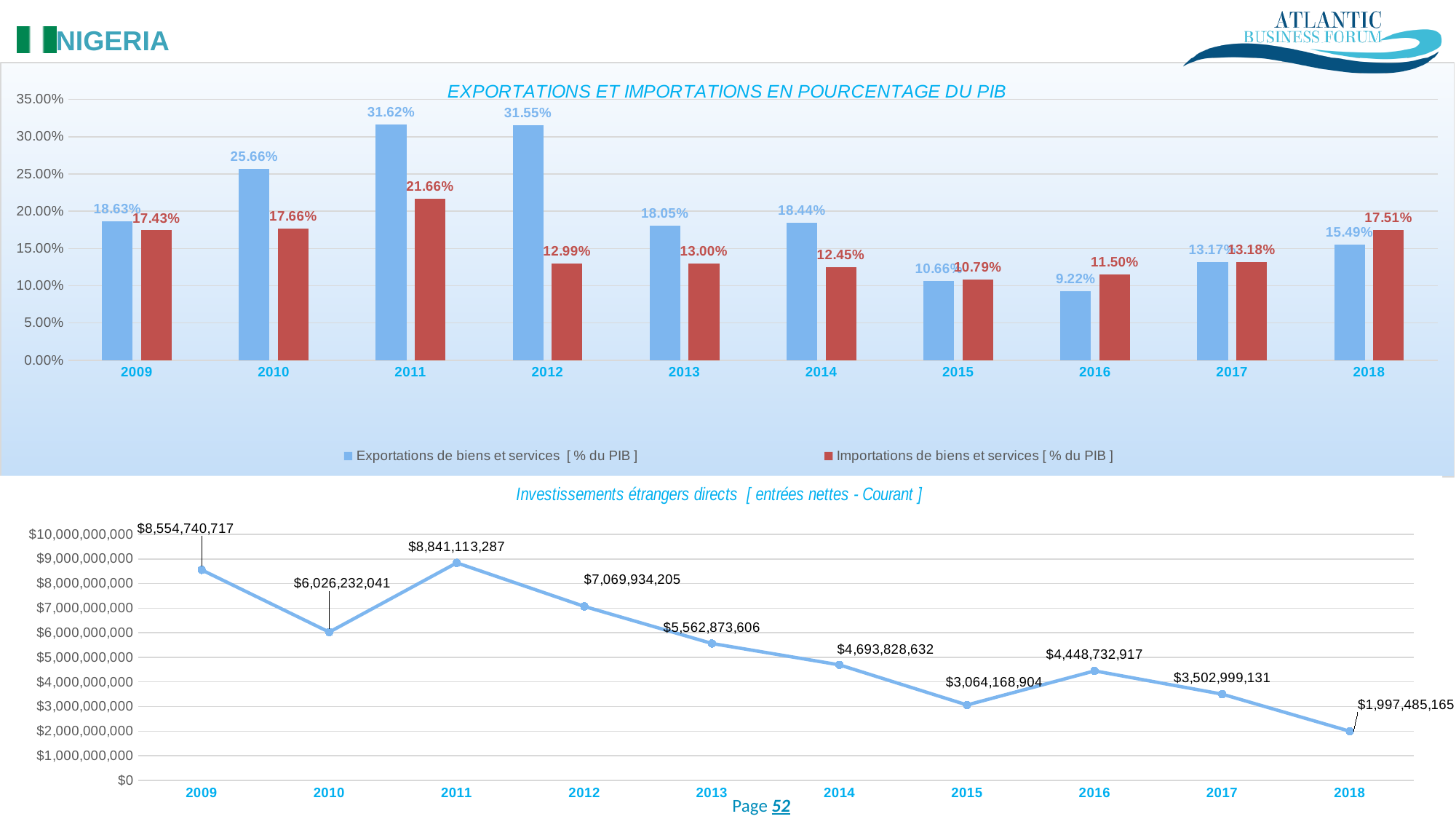
In the bottom chart, which year has the highest value? 2011 In the top chart, what is the difference between exports and imports in 2011? 9.96 percentage points In the top chart, what is the value of imports of goods and services in 2018? 17.51% In the bottom chart 'Investissements étrangers directs', what is the value for 2015? $3,064,168,904 In the top chart, which year has the lowest value for exports of goods and services? 2016 In the top chart, which year has the highest value for imports of goods and services? 2011 What type of chart is the top chart on the slide? Bar chart In the top chart 'EXPORTATIONS ET IMPORTATIONS EN POURCENTAGE DU PIB', what is the value of exports of goods and services in 2011? 31.62% In the bottom chart, what is the difference between the 2009 value and the 2018 value? $6,557,255,552 How many series does the legend of the top chart list? 2 How many years are plotted in the bottom chart? 10 In the top chart, which is larger in 2016: exports or imports? Imports